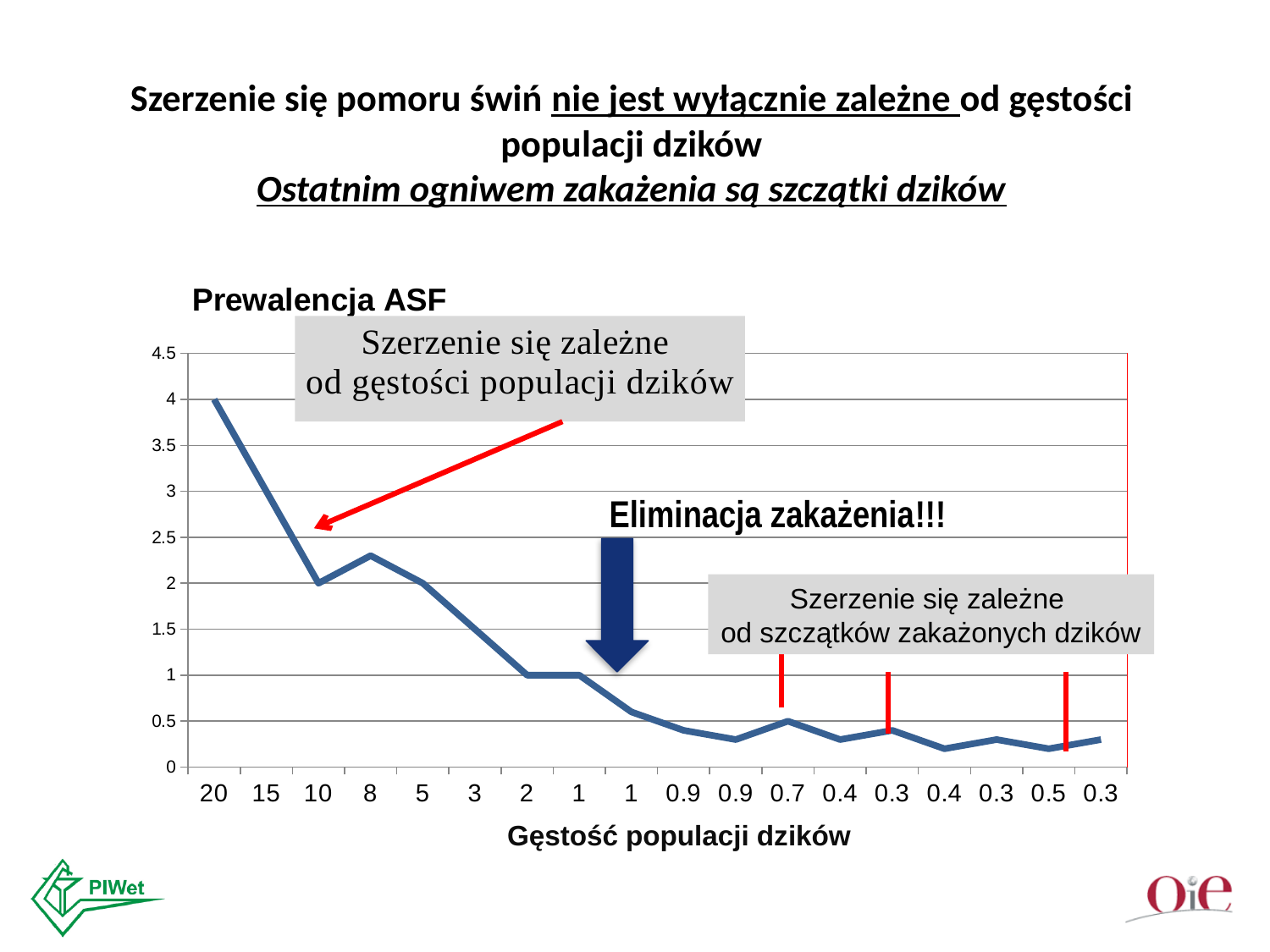
Is the value at population density 3 greater or less than 1? greater What is the ASF prevalence value at population density 20? 4 What is the ASF prevalence value at population density 10? 2 Is the value at population density 0.7 greater or less than 1? less What is the ASF prevalence value at population density 2? 1 Is the value at population density 8 greater or less than 2? greater Which has the larger value: population density 8 or population density 3? 8 What kind of chart is shown on the slide? line chart Do the values generally rise or fall moving from left to right along the x axis? fall How many data points are plotted along the x axis? 18 What is the title of the x axis? Gęstość populacji dzików At which x-axis category is the ASF prevalence highest? 20